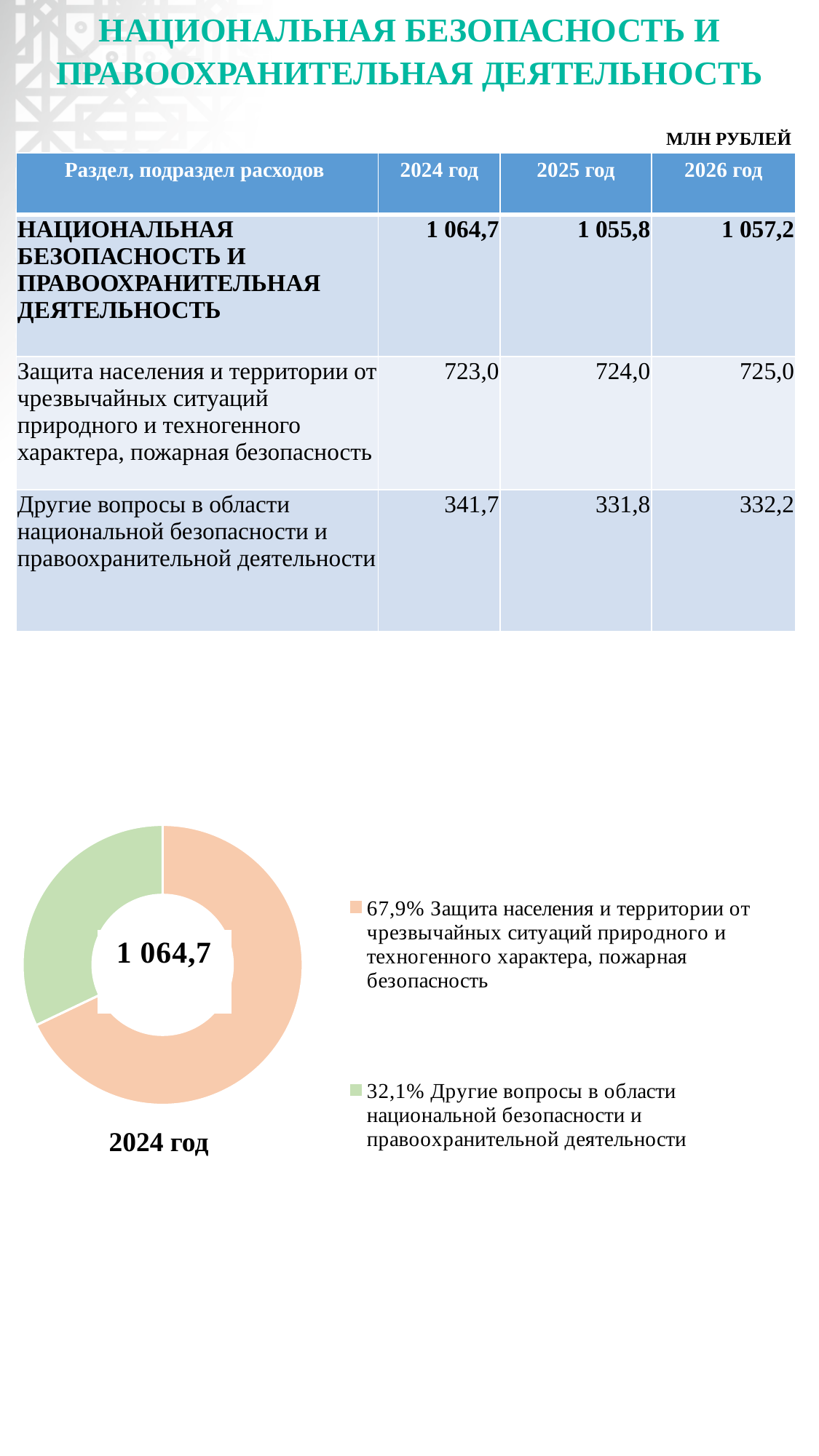
What share of the doughnut chart is taken by "Защита населения и территории от чрезвычайных ситуаций природного и техногенного характера, пожарная безопасность"? 67,9% What colour is the slice for "Другие вопросы в области национальной безопасности и правоохранительной деятельности" in the doughnut chart? Green Which year does the doughnut chart represent? 2024 год How many entries does the legend of the doughnut chart list? 2 Which slice of the doughnut chart is the largest? Защита населения и территории от чрезвычайных ситуаций природного и техногенного характера, пожарная безопасность By how many percentage points does the share of "Защита населения..." exceed the share of "Другие вопросы..." in the doughnut chart? 35,8 What kind of chart is shown at the bottom of the slide? Doughnut (pie) chart Which slice of the doughnut chart is the smallest? Другие вопросы в области национальной безопасности и правоохранительной деятельности In the doughnut chart, is the share for "Защита населения..." greater or less than 50%? greater What total value is printed in the centre of the doughnut chart? 1 064,7 How many slices does the doughnut chart have? 2 What share of the doughnut chart is taken by "Другие вопросы в области национальной безопасности и правоохранительной деятельности"? 32,1%